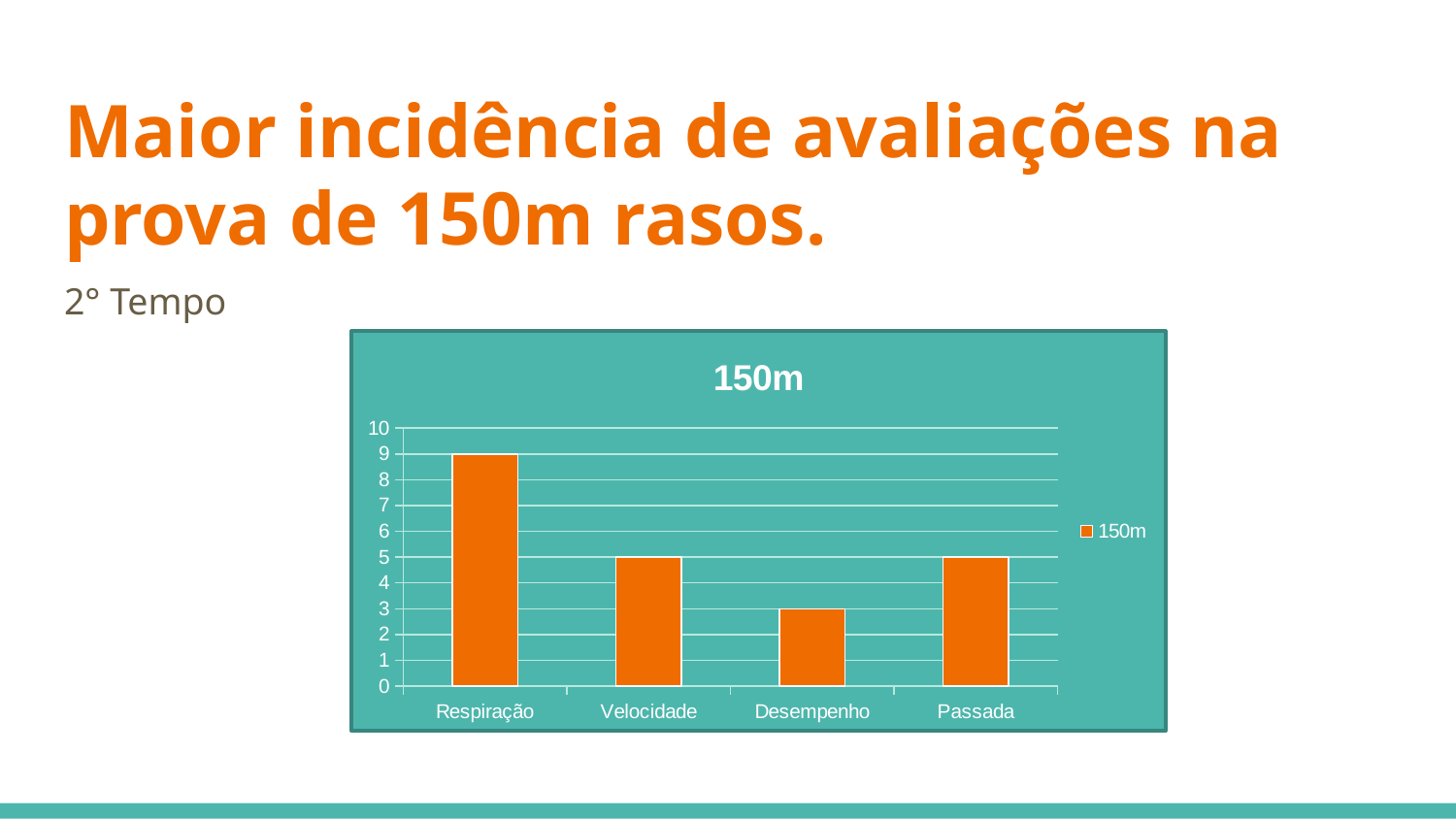
Which category has the lowest value? Desempenho What is the value for Desempenho? 3 Which category has the highest value? Respiração What is the value for Velocidade? 5 What kind of chart is shown on the slide? bar chart What is the title of the chart? 150m How many categories are shown on the x axis? 4 What is the difference between the values for Respiração and Desempenho? 6 Is the value for Respiração greater or less than 8? greater What is the value for Respiração? 9 Which is larger, the value for Velocidade or the value for Desempenho? Velocidade What is the value for Passada? 5